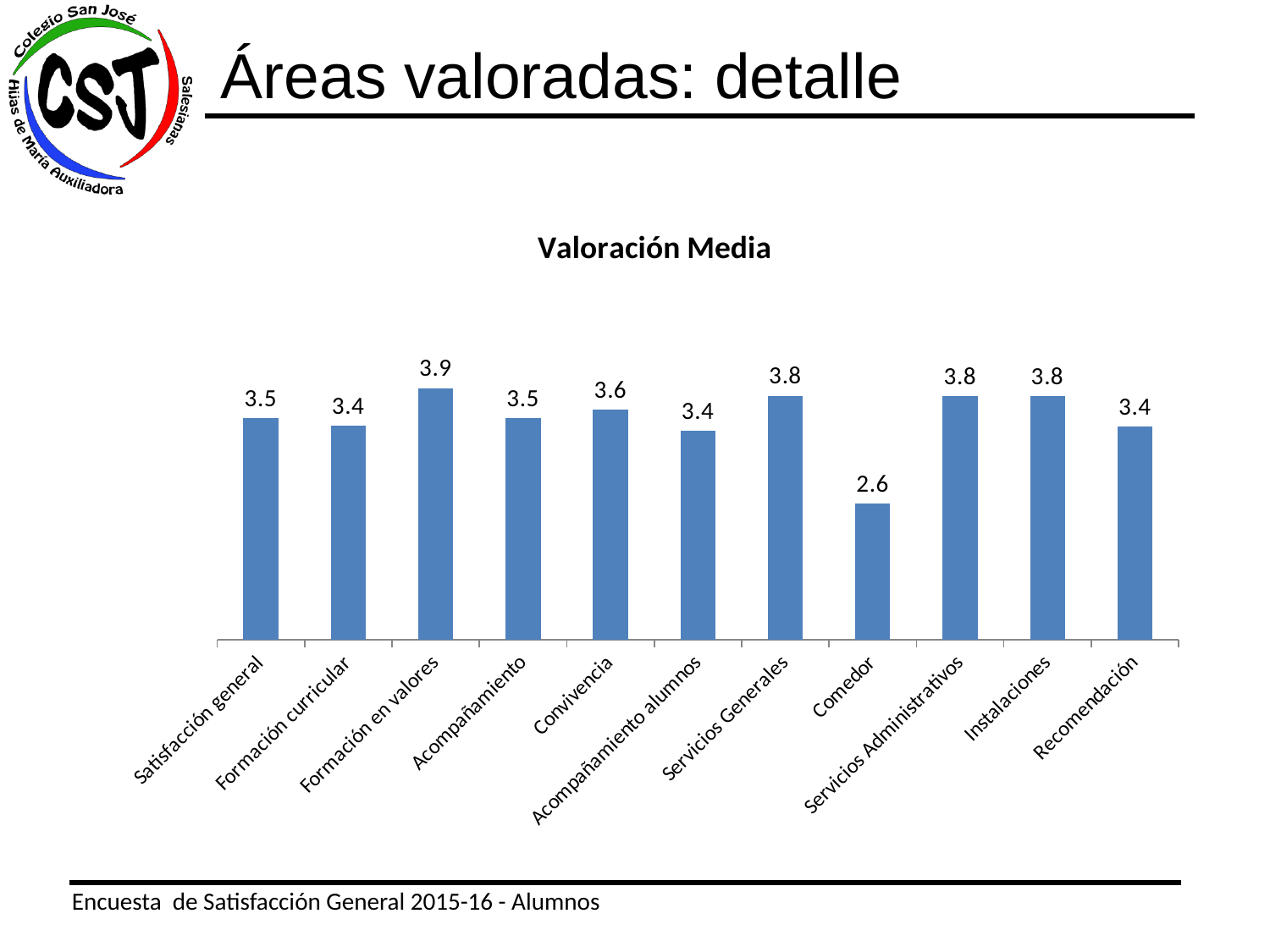
What kind of chart is shown on the slide? Bar chart What is the value for Convivencia? 3.6 Which is larger, the value for Convivencia or the value for Acompañamiento alumnos? Convivencia Which category has the lowest value? Comedor Which category has the highest value? Formación en valores How many categories are shown in the chart? 11 What is the difference between the values for Formación en valores and Comedor? 1.3 What is the value for Recomendación? 3.4 What is the title of the chart? Valoración Media What is the value for Comedor? 2.6 What is the value for Formación en valores? 3.9 What is the difference between the values for Servicios Generales and Satisfacción general? 0.3